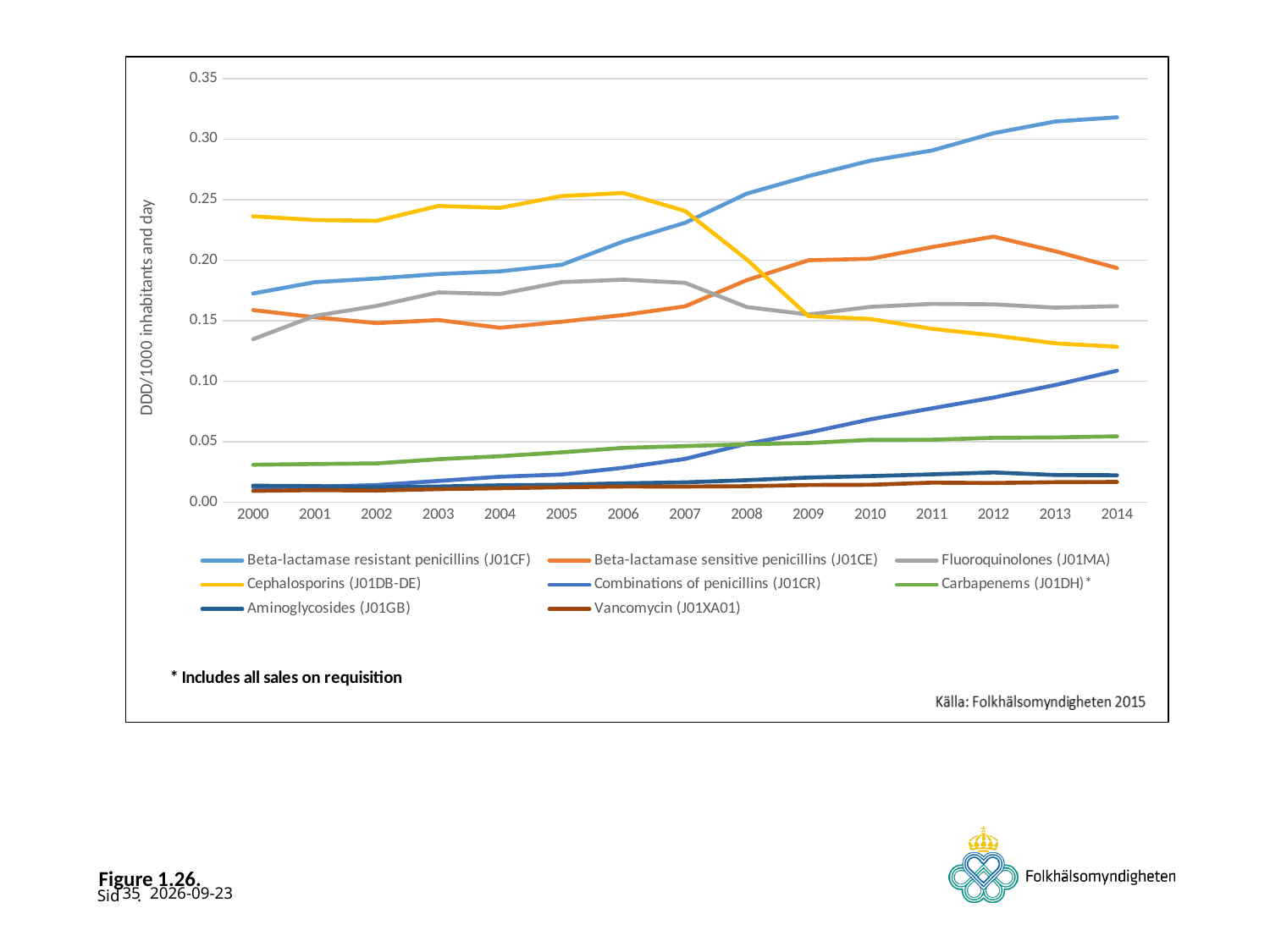
In 2009, which is larger: Beta-lactamase sensitive penicillins (J01CE) or Cephalosporins (J01DB-DE)? Beta-lactamase sensitive penicillins (J01CE) How many years are plotted along the x axis? 15 Do the values for Cephalosporins (J01DB-DE) rise or fall from 2006 to 2014? fall Is the value for Combinations of penicillins (J01CR) in 2014 greater or less than 0.05? greater Which series has the highest value in 2000? Cephalosporins (J01DB-DE) Is the value for Cephalosporins (J01DB-DE) in 2014 greater or less than 0.15? less Is the value for Beta-lactamase resistant penicillins (J01CF) in 2014 greater or less than 0.30? greater What is the title of the y axis? DDD/1000 inhabitants and day Do the values for Beta-lactamase resistant penicillins (J01CF) rise or fall from 2000 to 2014? rise How many series does the legend list? 8 What kind of chart is shown on the slide? line chart Which series has the highest value in 2014? Beta-lactamase resistant penicillins (J01CF)